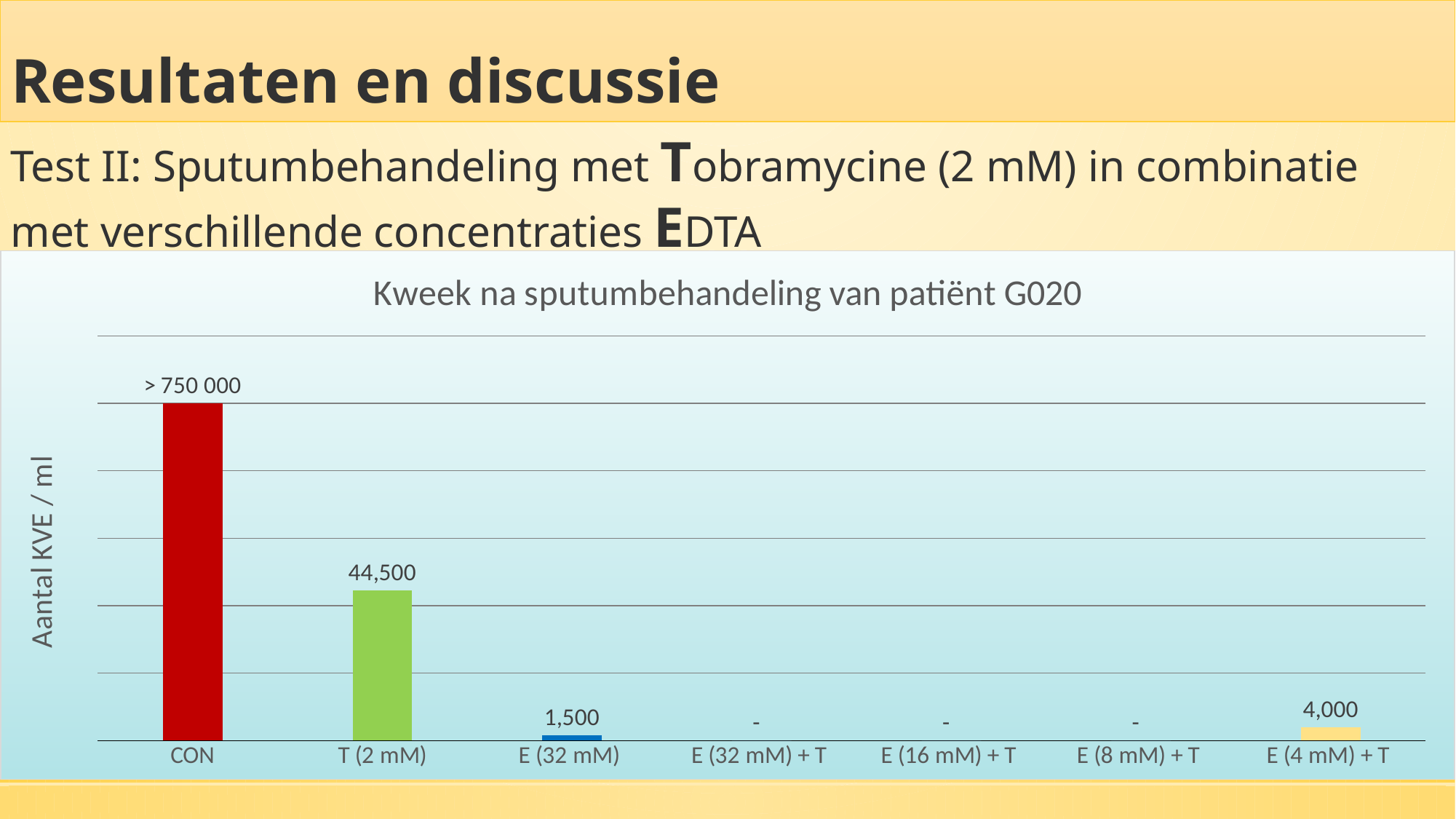
What is shown as the value for E (16 mM) + T? - What is the title of the chart? Kweek na sputumbehandeling van patiënt G020 What kind of chart is this? Bar chart What is the difference between the values for T (2 mM) and E (32 mM)? 43,000 What value is shown for E (4 mM) + T? 4,000 What value is shown for T (2 mM)? 44,500 What is the label of the y axis? Aantal KVE / ml How many categories are shown on the x axis? 7 Which is larger, the value for T (2 mM) or the value for E (4 mM) + T? T (2 mM) What value is shown for CON? > 750 000 Which category has the highest value? CON What value is shown for E (32 mM)? 1,500